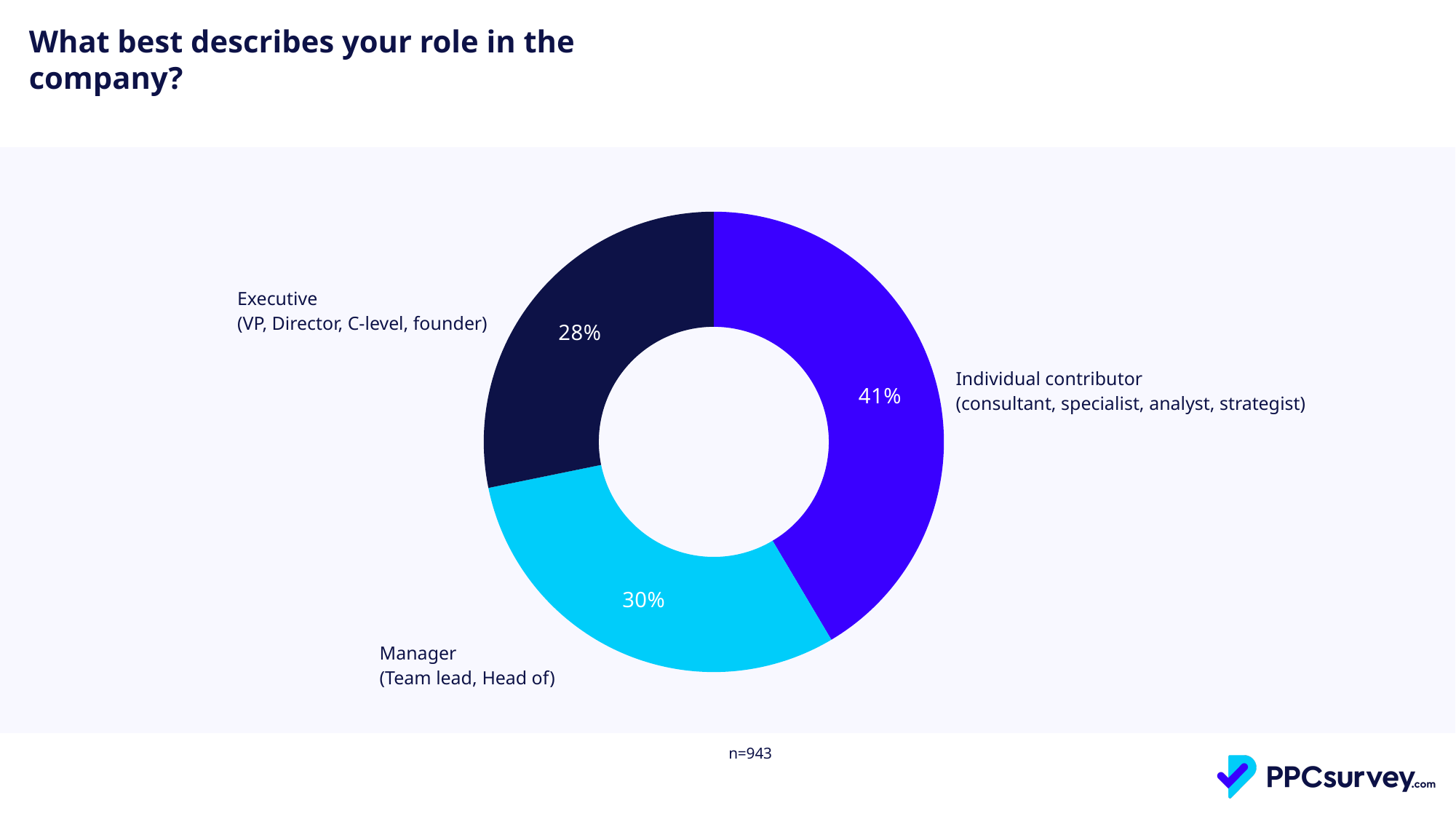
What is the sample size (n) shown on the slide? n=943 What is the difference in percentage points between Individual contributor and Executive? 13 What percentage of respondents are Managers (Team lead, Head of)? 30% What kind of chart is shown on the slide? Donut (pie) chart What percentage of respondents are Individual contributors? 41% How many role categories are shown in the chart? 3 Which role has the largest share of respondents? Individual contributor What is the title of the chart? What best describes your role in the company? What percentage of respondents are Executives (VP, Director, C-level, founder)? 28% Which role has the smallest share of respondents? Executive Which is larger, the share for Manager or the share for Individual contributor? Individual contributor What is the difference in percentage points between Manager and Executive? 2